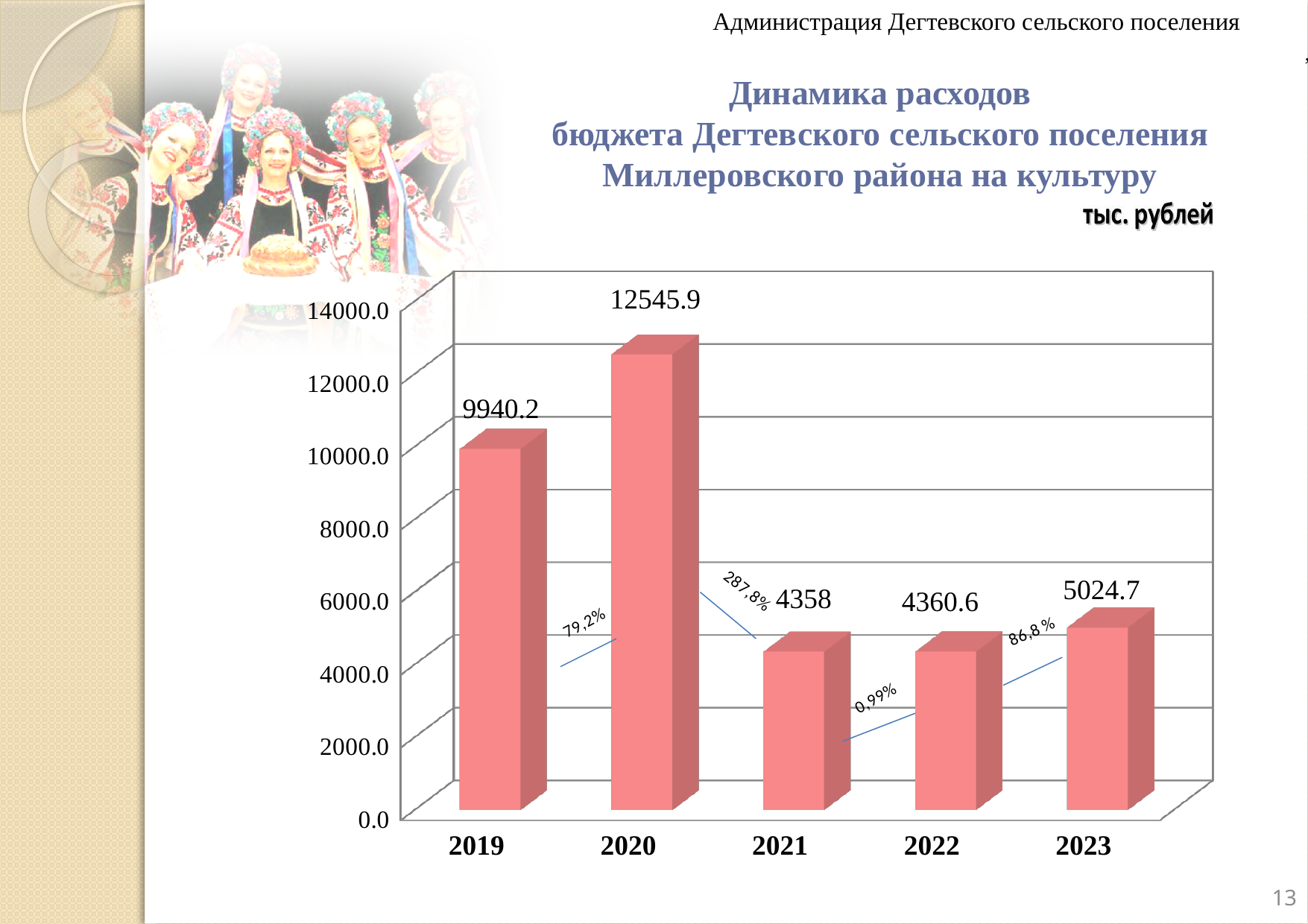
Which year has the highest value? 2020 What unit is stated for the values in the chart? тыс. рублей What is the value for 2019? 9940.2 How many years are shown on the x axis? 5 What is the value for 2021? 4358 What is the value for 2022? 4360.6 What is the difference between the values for 2020 and 2019? 2605.7 What kind of chart is shown on the slide? bar chart Which is larger, the value for 2023 or the value for 2022? 2023 What is the value for 2020? 12545.9 What is the value for 2023? 5024.7 Which year has the lowest value? 2021